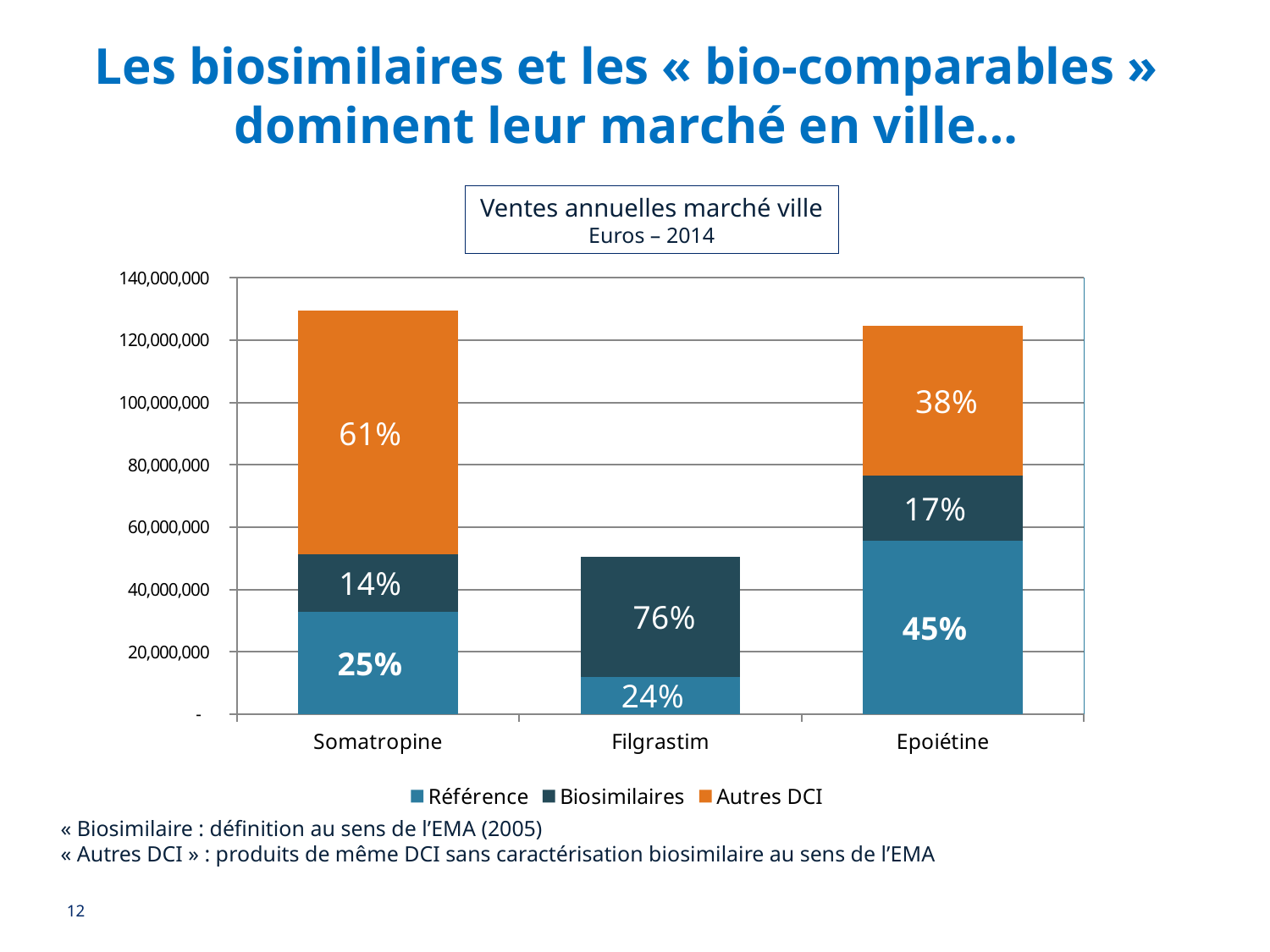
Within the Filgrastim bar, which share is larger: Référence or Biosimilaires? Biosimilaires Is the total value of the Filgrastim bar greater or less than 60,000,000? less How many series does the legend list? 3 What type of chart is shown on the slide? Stacked bar chart How many categories are shown on the x axis? 3 What percentage label is shown for the Biosimilaires segment of the Filgrastim bar? 76% Is the total value of the Somatropine bar greater or less than 120,000,000? greater What percentage label is shown for the Autres DCI segment of the Somatropine bar? 61% What percentage label is shown for the Référence segment of the Epoiétine bar? 45% What is the difference in percentage points between the Autres DCI share (61%) and the Référence share (25%) of the Somatropine bar? 36 percentage points What percentage label is shown for the Biosimilaires segment of the Epoiétine bar? 17% Which category has the lowest total annual sales? Filgrastim